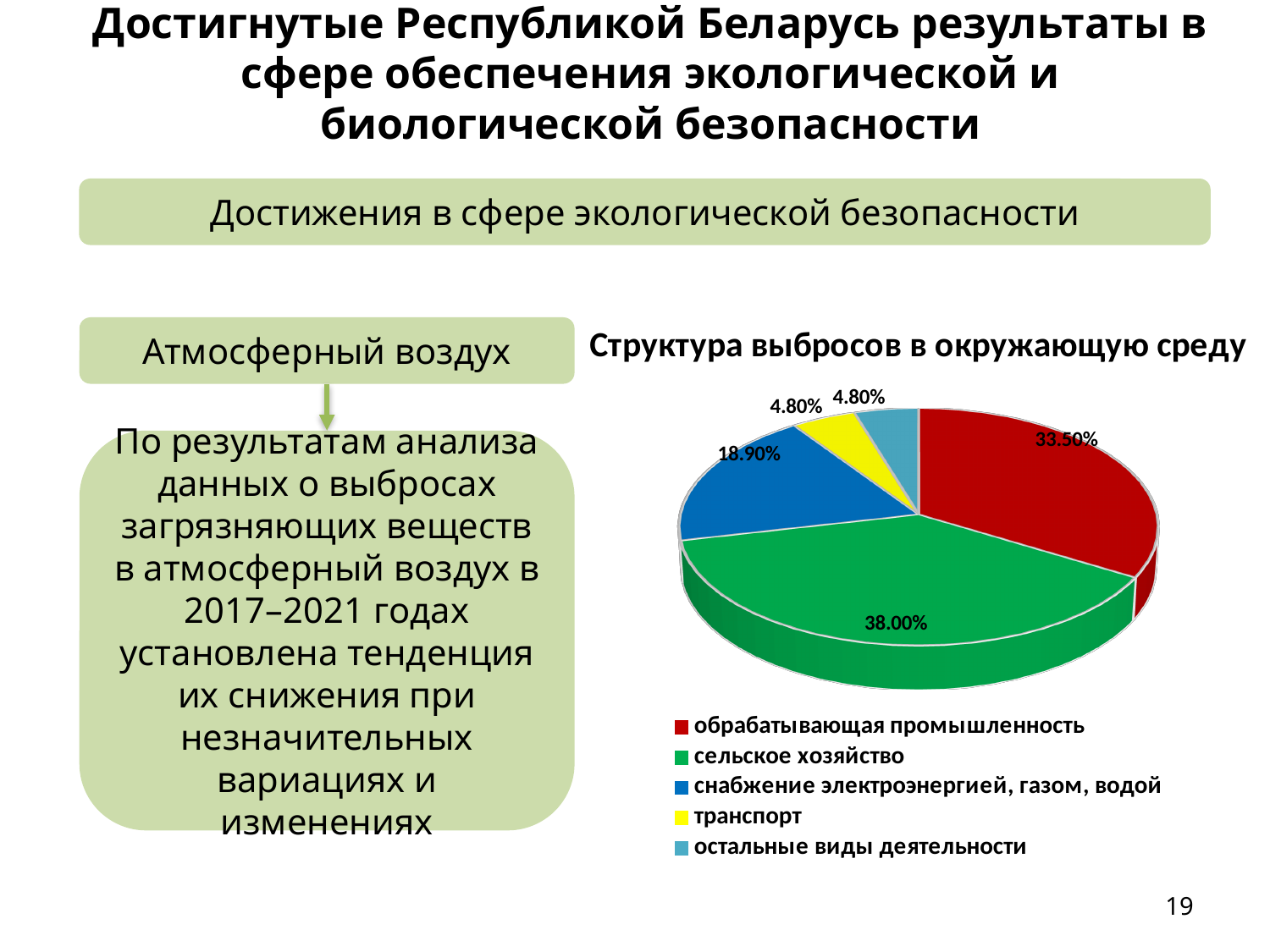
How many slices does the pie chart have? 5 Which is larger: the share of обрабатывающая промышленность or the share of снабжение электроэнергией, газом, водой? обрабатывающая промышленность What is the value shown for транспорт? 4.80% Which category has the largest share of the pie? сельское хозяйство What is the title of the chart on the slide? Структура выбросов в окружающую среду Which colour represents остальные виды деятельности in the pie chart? Light blue What type of chart is shown on the slide? Pie chart What share of the pie does сельское хозяйство account for? 38.00% What is the value shown for обрабатывающая промышленность? 33.50% How many entries does the chart legend list? 5 What is the value shown for снабжение электроэнергией, газом, водой? 18.90% What is the difference between the shares of сельское хозяйство and обрабатывающая промышленность? 4.50%